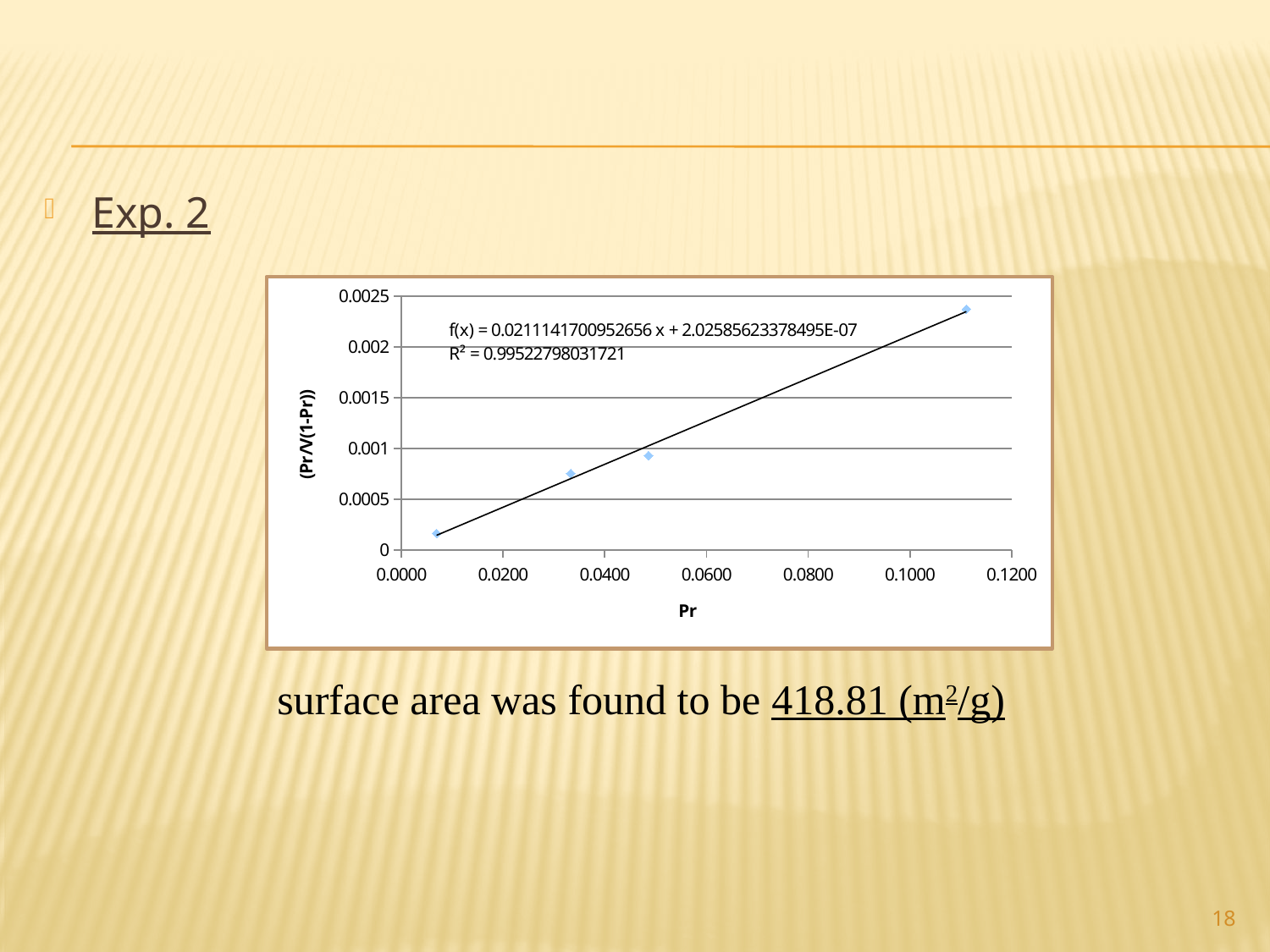
Is the y value of the data point near Pr 0.0480 greater or less than 0.0005? greater Which has the larger y value: the data point near Pr 0.0333 or the data point near Pr 0.0480? the point near Pr 0.0480 Do the plotted values rise or fall as Pr increases along the x axis? rise What kind of chart is shown on the slide? scatter chart with a linear trendline Is the y value of the rightmost data point (near Pr 0.1100) greater or less than 0.002? greater Is the y value of the leftmost data point (near Pr 0.0067) greater or less than 0.0005? less What R² value is printed on the chart? 0.99522798031721 What is the x-axis title of the chart? Pr How many data points are plotted on the chart? 4 What is the y-axis title of the chart? (Pr/V(1-Pr)) Does the highest y value occur at the largest or the smallest Pr value? largest